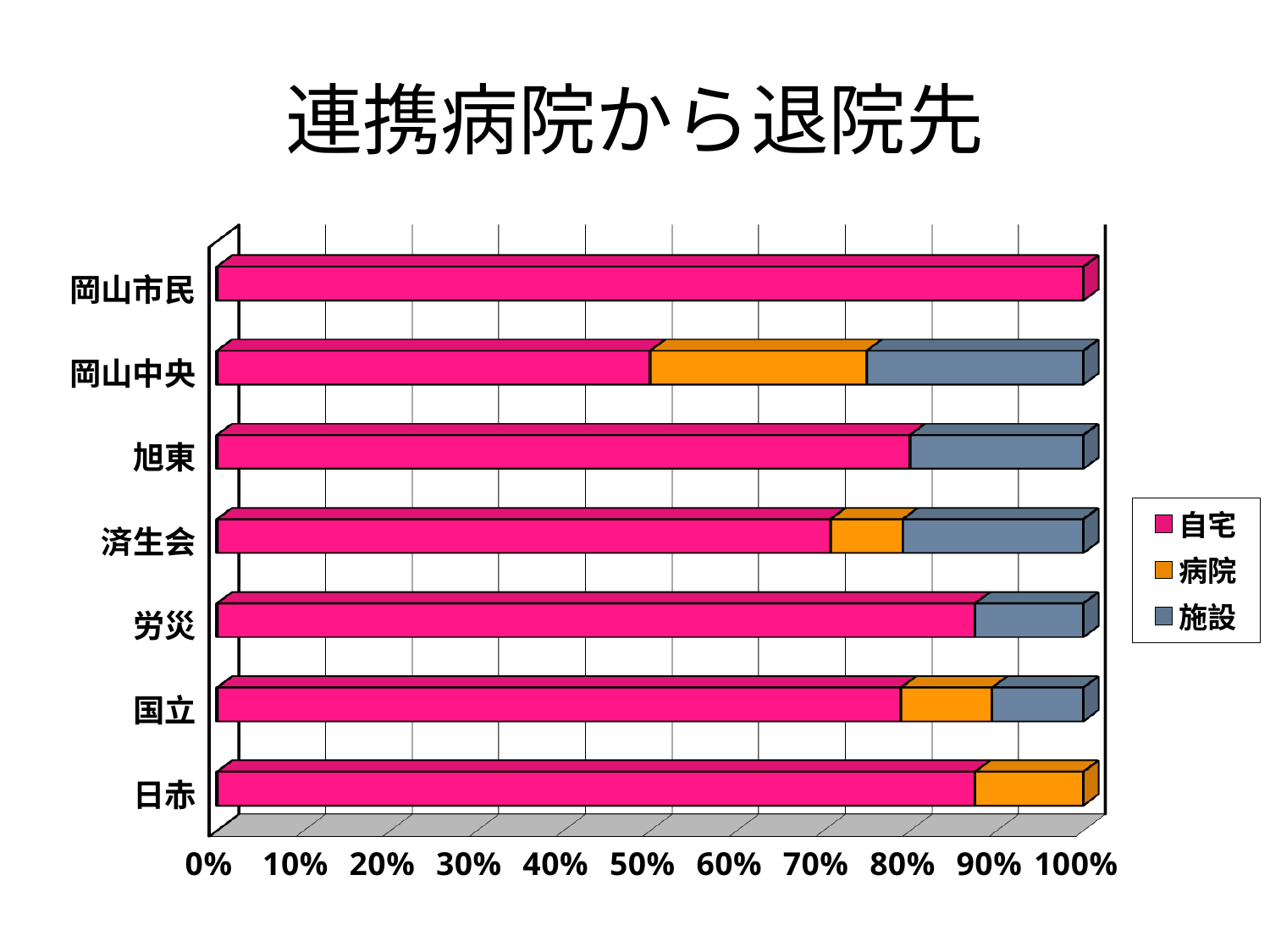
How many hospitals (categories) are listed on the vertical axis? 7 Is the 自宅 share for 岡山中央 greater or less than 60%? less What is the title of the chart? 連携病院から退院先 Which hospital has the largest 病院 share? 岡山中央 How many series does the legend list? 3 Which has the larger 自宅 share, 旭東 or 済生会? 旭東 What is the 自宅 share for 岡山市民? 100% Which hospital has the lowest 自宅 share? 岡山中央 What kind of chart is shown on the slide? Stacked bar chart Which hospital has the highest 自宅 share? 岡山市民 Is the 自宅 share for 労災 greater or less than 80%? greater Which series is shown in orange in the legend? 病院